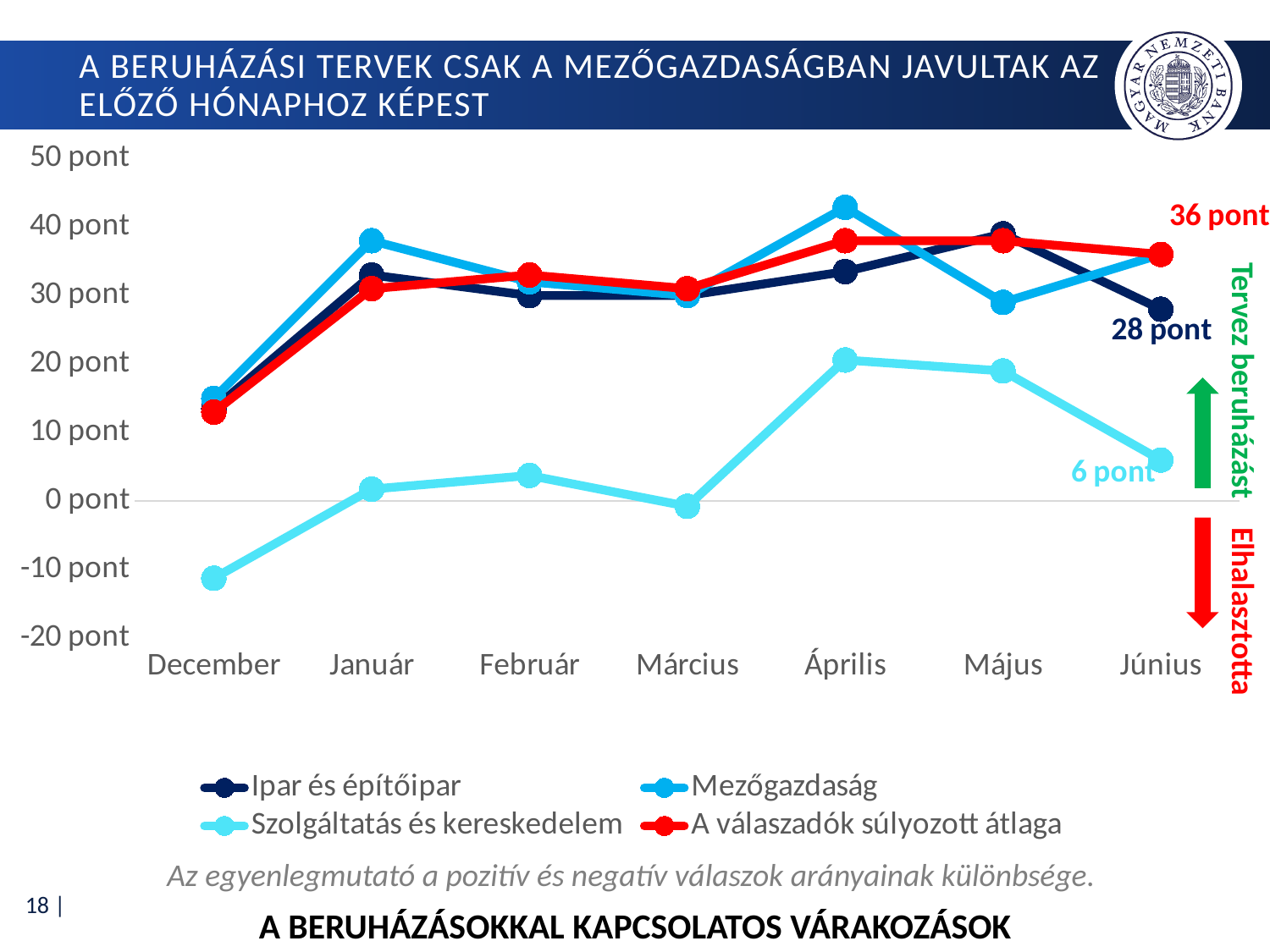
Is the value for 'Szolgáltatás és kereskedelem' in December greater or less than 0 pont? less What is the difference between the Június values of 'A válaszadók súlyozott átlaga' and 'Ipar és építőipar'? 8 pont What is the value of 'Ipar és építőipar' in Június? 28 pont How many series does the legend list? 4 In which month does 'Szolgáltatás és kereskedelem' reach its lowest value? December What kind of chart is shown on the slide? line chart Which series has the highest value in Április? Mezőgazdaság Is the value for 'Mezőgazdaság' in Április greater or less than 40 pont? greater What is the value of 'A válaszadók súlyozott átlaga' in Június? 36 pont Does the 'Szolgáltatás és kereskedelem' line rise or fall from Május to Június? fall What is the value of 'Szolgáltatás és kereskedelem' in Június? 6 pont How many months are shown on the x axis? 7